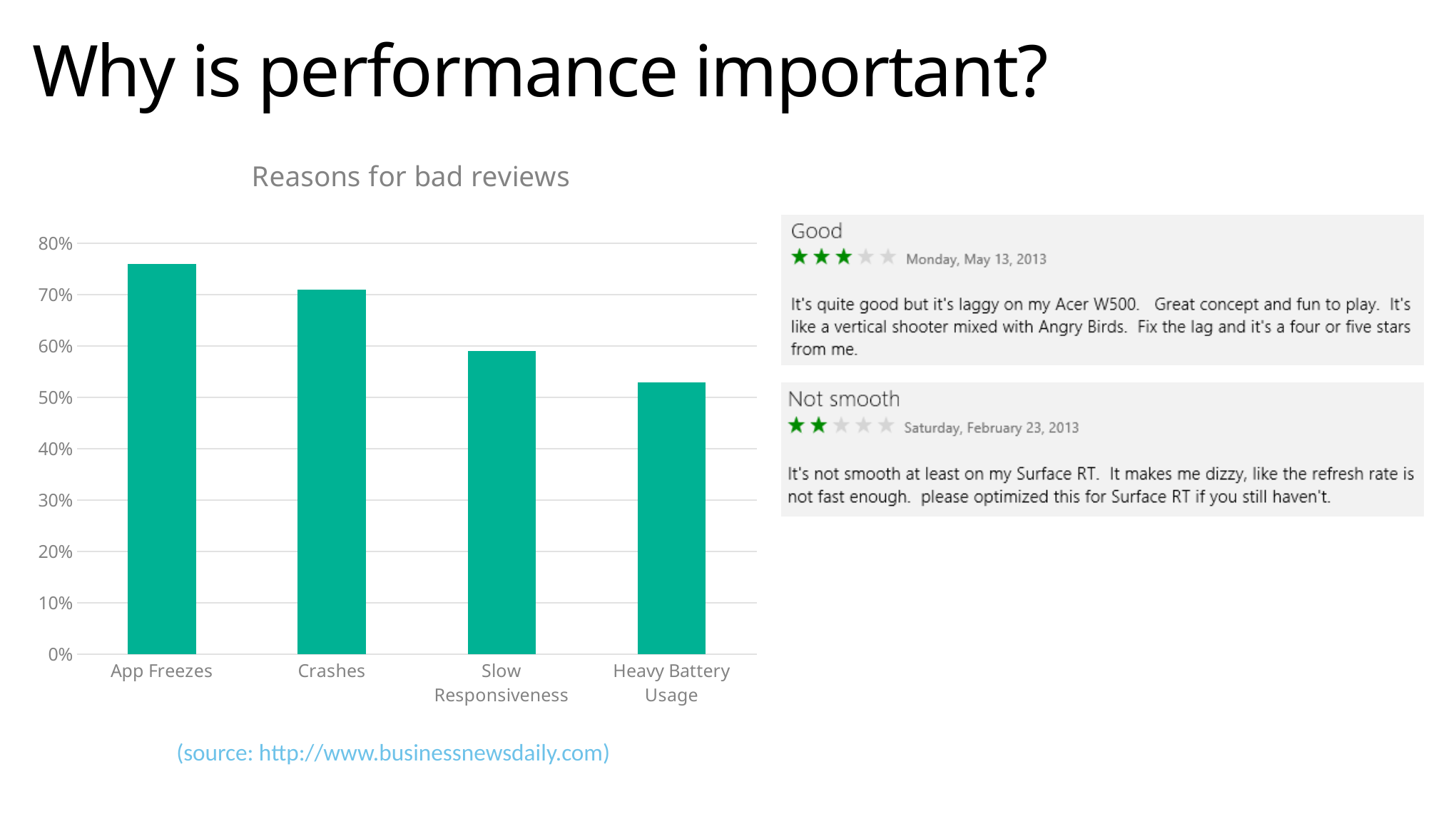
How many categories are shown in the 'Reasons for bad reviews' chart? 4 Which category has the highest value in the 'Reasons for bad reviews' chart? App Freezes Which category has the lowest value in the 'Reasons for bad reviews' chart? Heavy Battery Usage Is the value for Crashes greater or less than 80%? less Do the values rise or fall moving from left to right across the categories? Fall What is the title of the chart on the slide? Reasons for bad reviews What type of chart is shown under the title 'Reasons for bad reviews'? Bar chart Is the value for Slow Responsiveness greater or less than 50%? greater Is the value for Heavy Battery Usage greater or less than 60%? less Which is larger, the value for Heavy Battery Usage or the value for App Freezes? App Freezes Which is larger, the value for Crashes or the value for Slow Responsiveness? Crashes